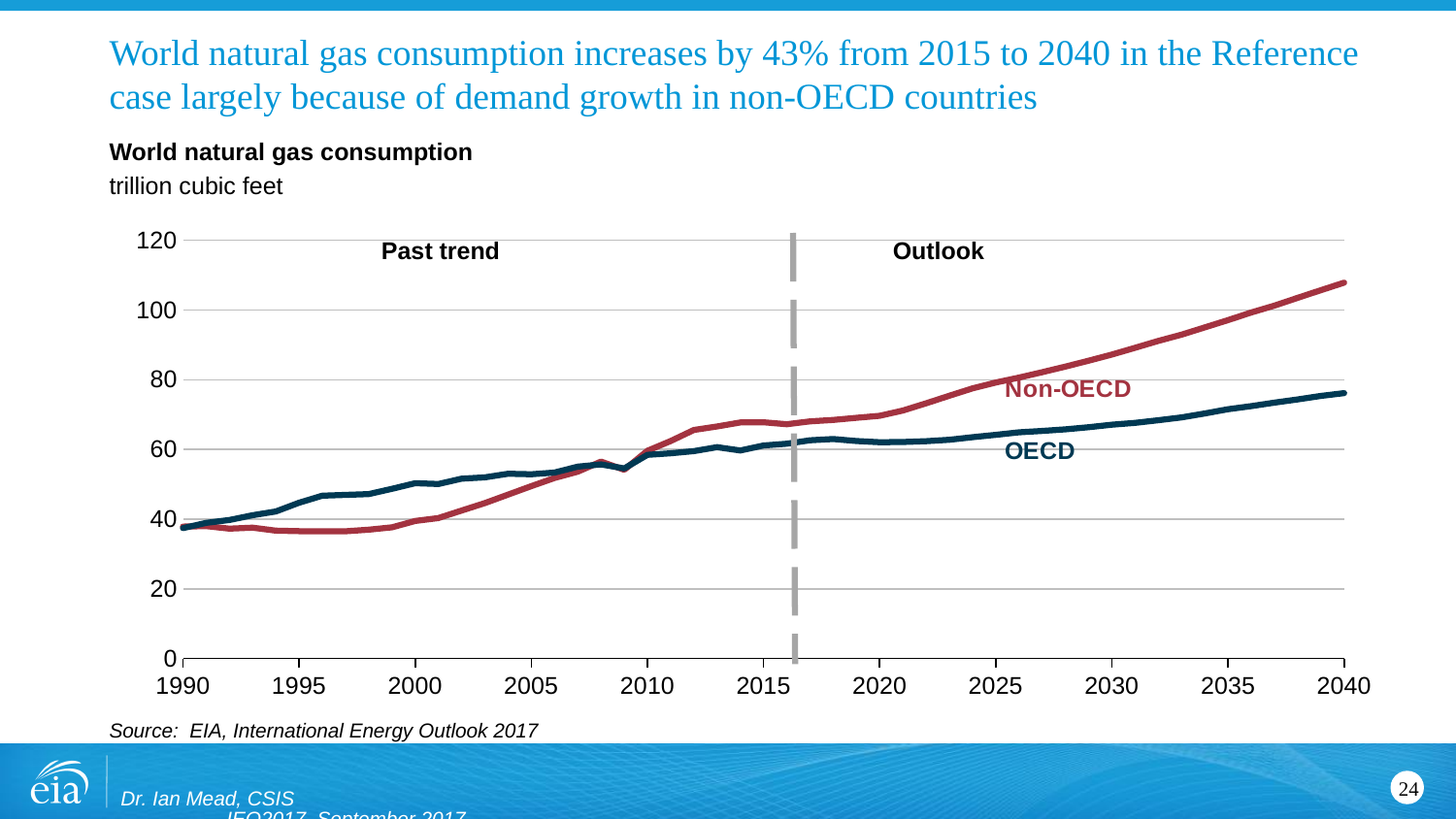
Is the OECD value in 2040 greater or less than 80? less What are the two labels placed on either side of the dashed vertical line? Past trend and Outlook Is the OECD value in 2030 greater or less than 60? greater How many series are plotted on the chart? 2 Which series has the higher value in 2040, OECD or Non-OECD? Non-OECD Is the Non-OECD value in 2040 greater or less than 100? greater Which series has the higher value in 2000, OECD or Non-OECD? OECD What kind of chart is shown on the slide? line chart What unit is the chart's y axis measured in? trillion cubic feet Does the Non-OECD series rise or fall from 2015 to 2040? rise